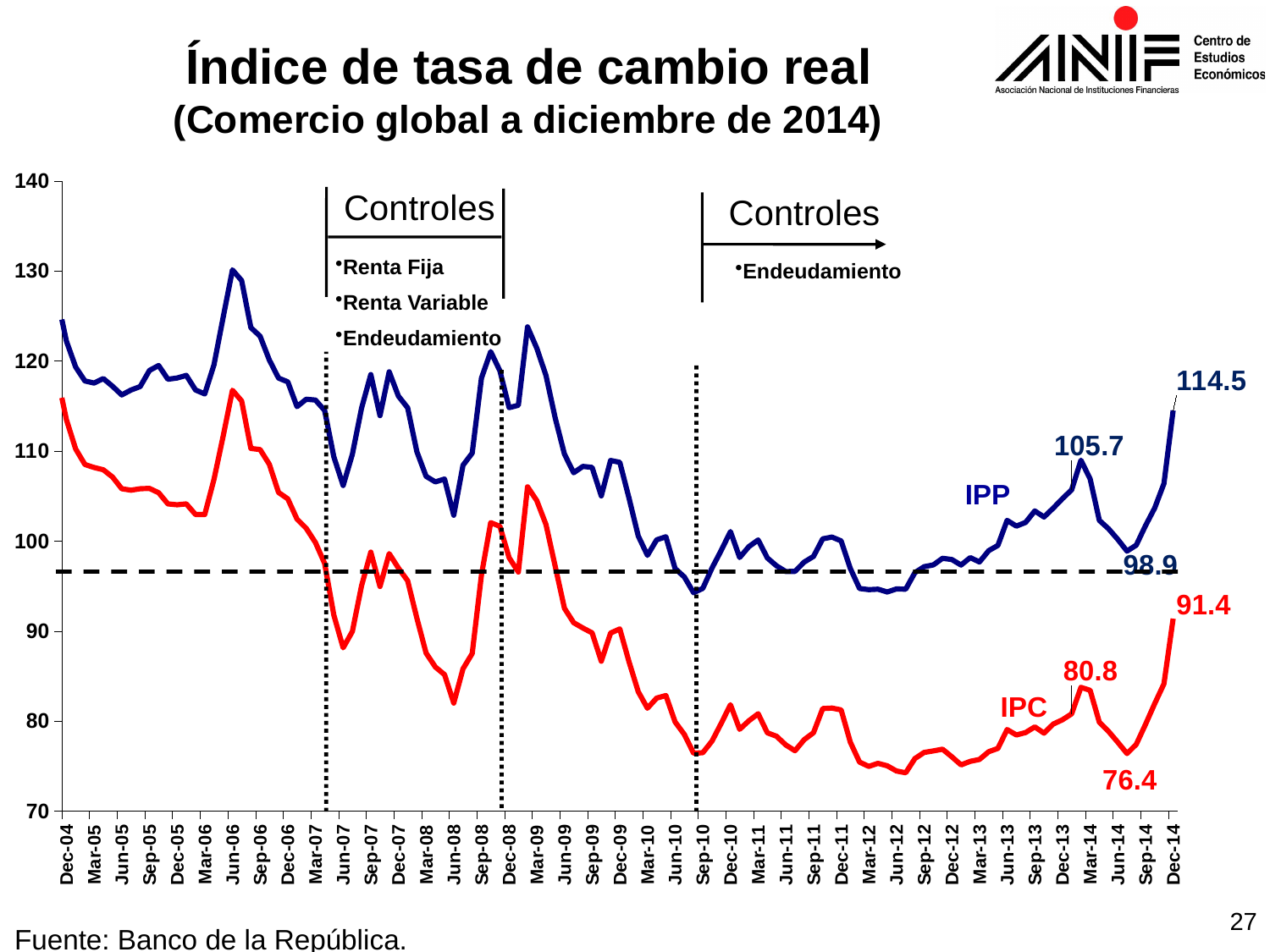
What is the title of the chart? Índice de tasa de cambio real (Comercio global a diciembre de 2014) What is the difference between the labelled IPC values 80.8 and 76.4? 4.4 Is the value of the IPC series at Sep-10 greater or less than 80? less What is the value of the IPP series at Dec-14? 114.5 What is the value of the IPC series at Dec-14? 91.4 What is the difference between the IPP and IPC values at Dec-14? 23.1 Is the value of the IPP series at Jun-06 greater or less than 120? greater Which series has the higher value at Dec-14, IPP or IPC? IPP What is the difference between the labelled IPP peak of 105.7 and the labelled IPP low of 98.9? 6.8 Is the value of the IPC series at Dec-04 greater or less than 110? greater How many series are plotted on the chart? 2 What kind of chart is shown on the slide? line chart